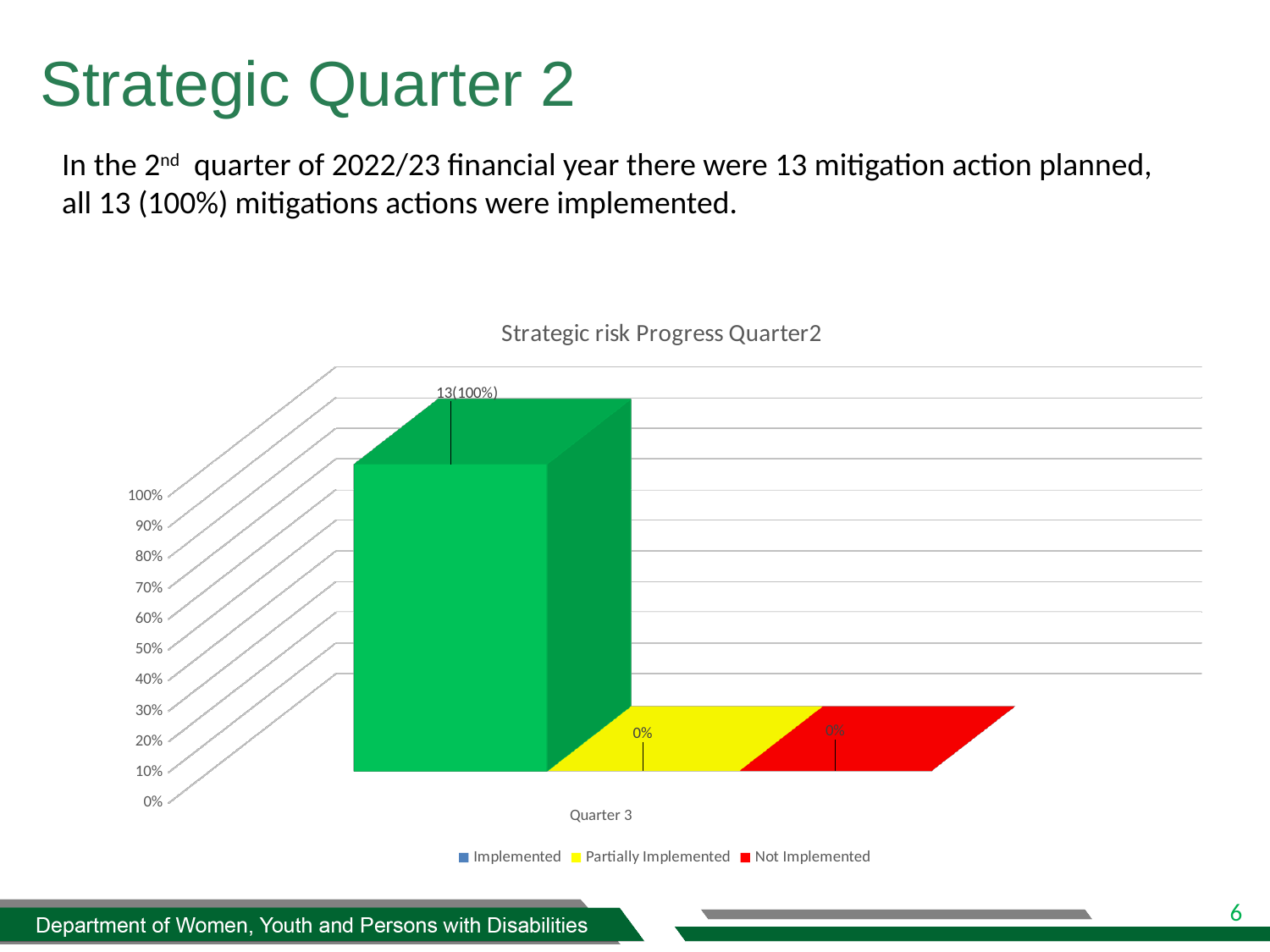
What is the difference between the Partially Implemented value and the Not Implemented value? 0% What value is shown for Not Implemented? 0% What value is shown for Partially Implemented? 0% Which series has the highest value in the chart? Implemented Which is larger, the value for Implemented or the value for Not Implemented? Implemented How many series does the chart legend list? 3 How many categories are shown on the horizontal axis of the chart? 1 What is the data label shown on the Implemented bar? 13(100%) Is the value for Implemented greater or less than 50%? greater What is the category label shown on the horizontal axis of the chart? Quarter 3 What is the title of the chart? Strategic risk Progress Quarter2 What type of chart is shown on the slide? bar chart